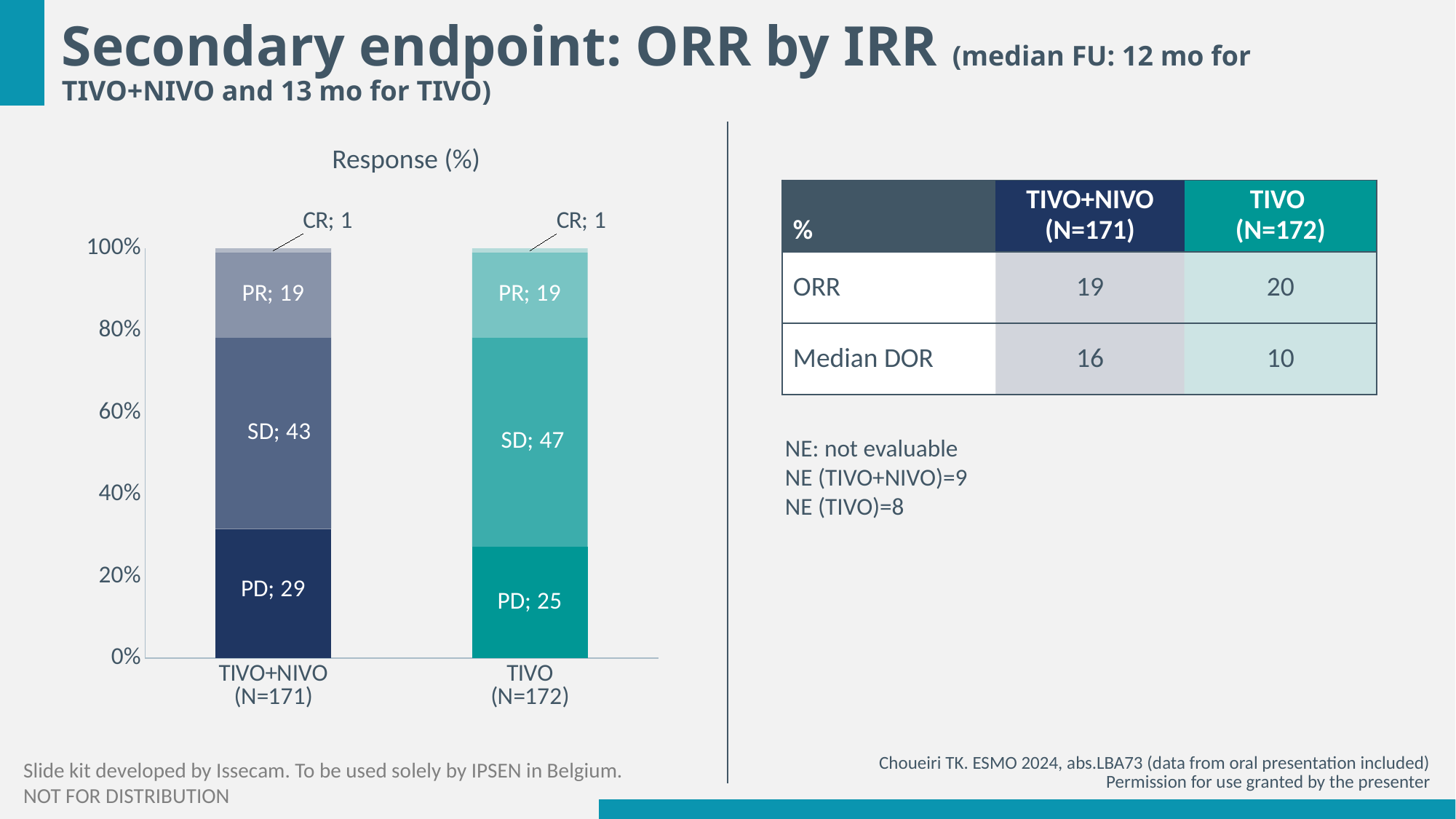
What is the SD value for TIVO (N=172)? 47 Which response category is the smallest segment in the TIVO+NIVO (N=171) bar? CR Which response category is the largest segment in the TIVO (N=172) bar? SD What is the difference between the PD value for TIVO+NIVO and the PD value for TIVO? 4 What is the PR value for TIVO (N=172)? 19 How many bars (treatment arms) are shown in the chart? 2 What kind of chart is shown on the slide? Stacked bar chart What is the PD value for TIVO+NIVO (N=171)? 29 Which arm has the larger PD value, TIVO+NIVO or TIVO? TIVO+NIVO Which arm has the larger SD value, TIVO+NIVO or TIVO? TIVO What is the difference between the SD value for TIVO and the SD value for TIVO+NIVO? 4 What is the CR value for TIVO+NIVO (N=171)? 1